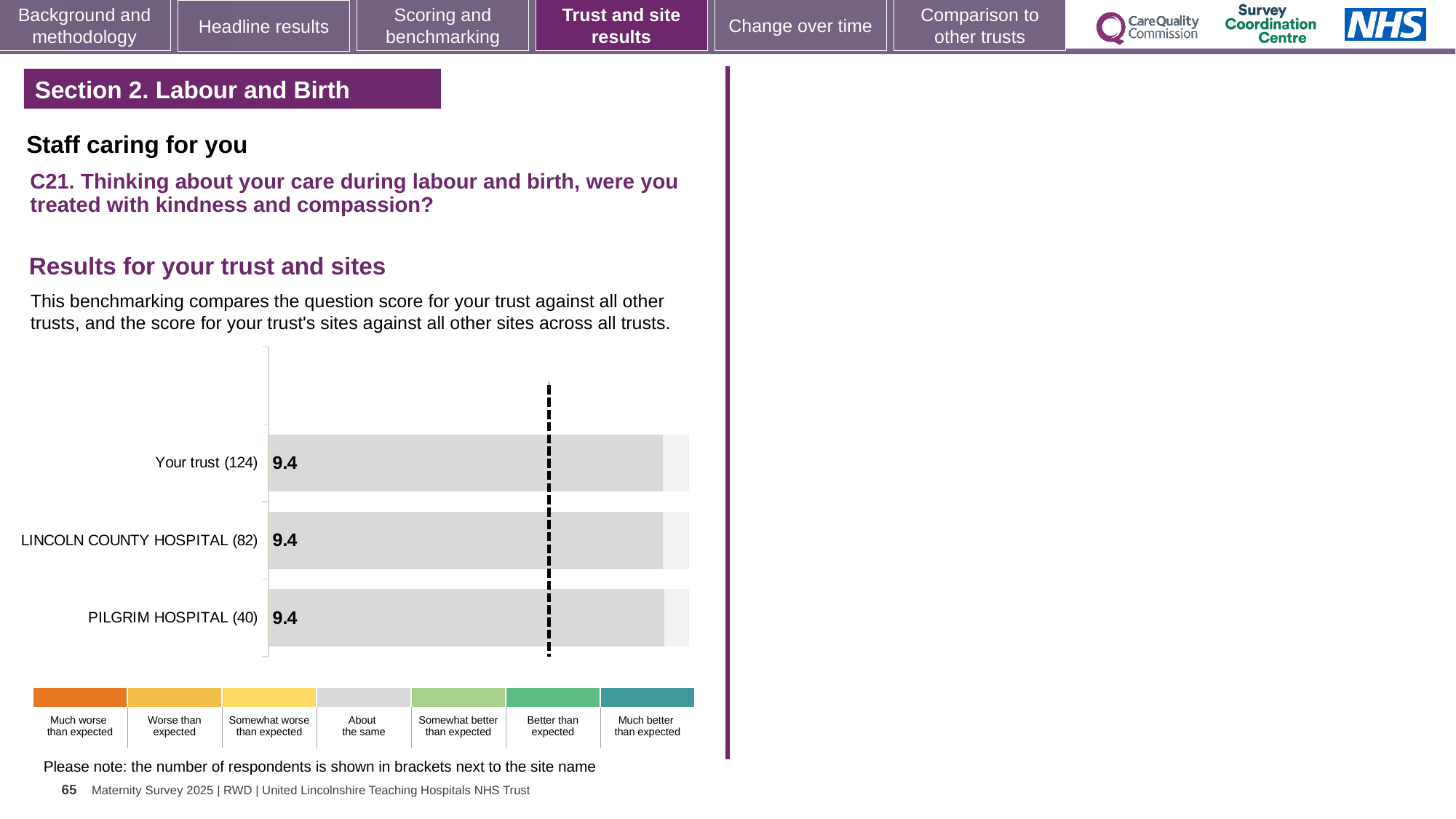
How many bars are plotted in the chart? 3 What is the score for Your trust? 9.4 What is the difference between the score for LINCOLN COUNTY HOSPITAL and the score for PILGRIM HOSPITAL? 0 How many rating categories does the colour key below the chart list? 7 Do all three bars in the chart show the same score? Yes What is the score for PILGRIM HOSPITAL? 9.4 How many respondents are shown in brackets for PILGRIM HOSPITAL? 40 What is the score for LINCOLN COUNTY HOSPITAL? 9.4 How many respondents are shown in brackets for Your trust? 124 How many respondents are shown in brackets for LINCOLN COUNTY HOSPITAL? 82 What kind of chart is shown on the slide? Bar chart Which survey question does the chart relate to? C21. Thinking about your care during labour and birth, were you treated with kindness and compassion?